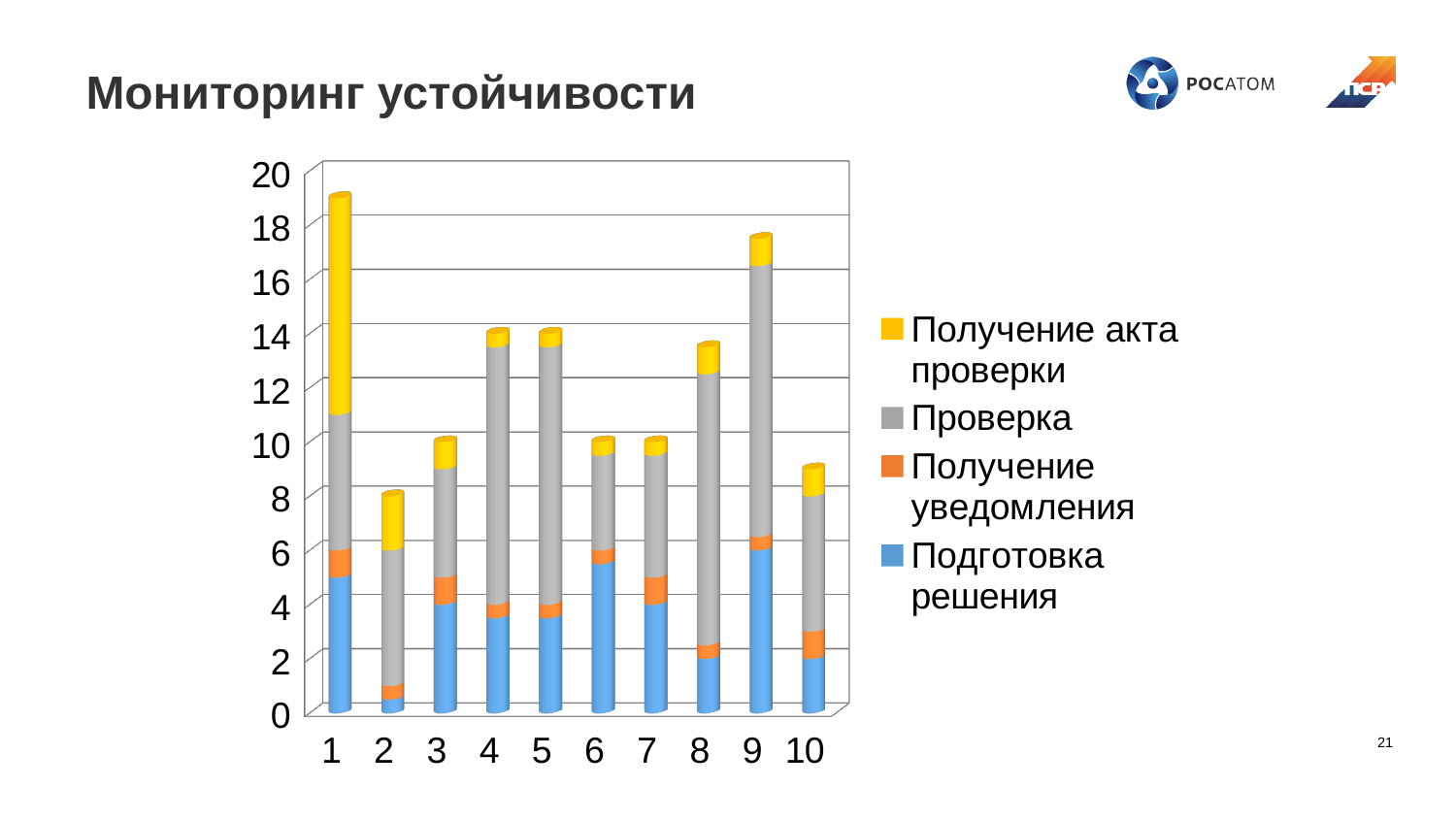
Which category has the tallest stacked bar? 1 How many series does the chart legend list? 4 What is the title of the slide containing the chart? Мониторинг устойчивости Which stacked bar is taller, category 4 or category 2? 4 Is the total stacked value for category 10 greater or less than 10? less How many categories are shown along the x axis of the chart? 10 Is the total stacked value for category 2 greater or less than 10? less Which stacked bar is taller, category 1 or category 9? 1 Which colour represents the series "Проверка" in the chart? Grey Is the total stacked value for category 9 greater or less than 16? greater What kind of chart is shown on the slide? Stacked bar chart